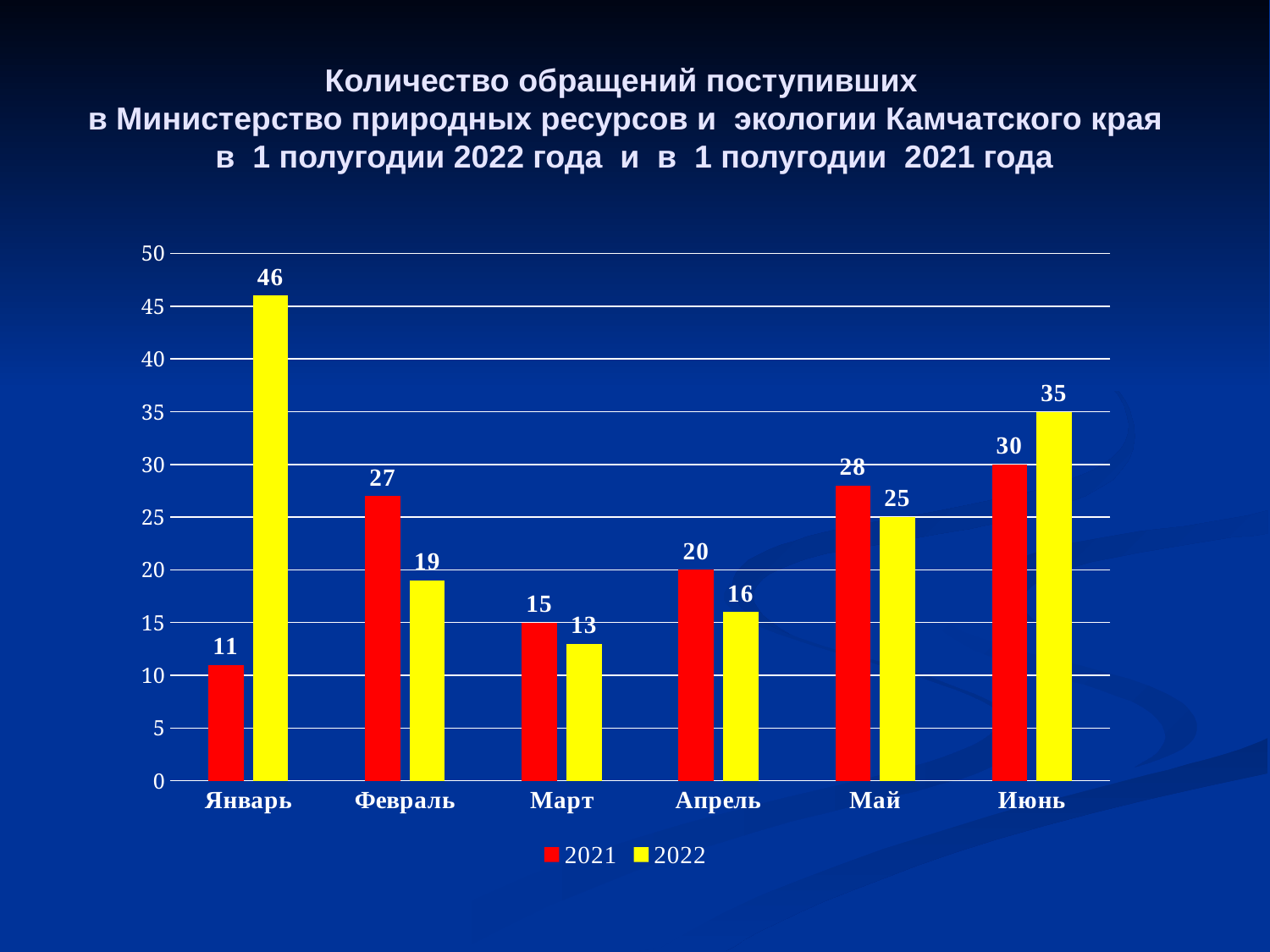
Is the value for 2022 in Июнь greater or less than 30? greater Which is larger in Февраль, the 2021 value or the 2022 value? 2021 Which month has the highest value for the 2021 series? Июнь What colour are the bars for the 2022 series? yellow What is the value for 2022 in Март? 13 What is the difference between the 2022 and 2021 values in Январь? 35 How many series does the legend list? 2 What is the value for 2022 in Январь? 46 What kind of chart is shown on the slide? bar chart What is the value for 2021 in Май? 28 Which month has the lowest value for the 2022 series? Март How many months are shown on the x axis? 6